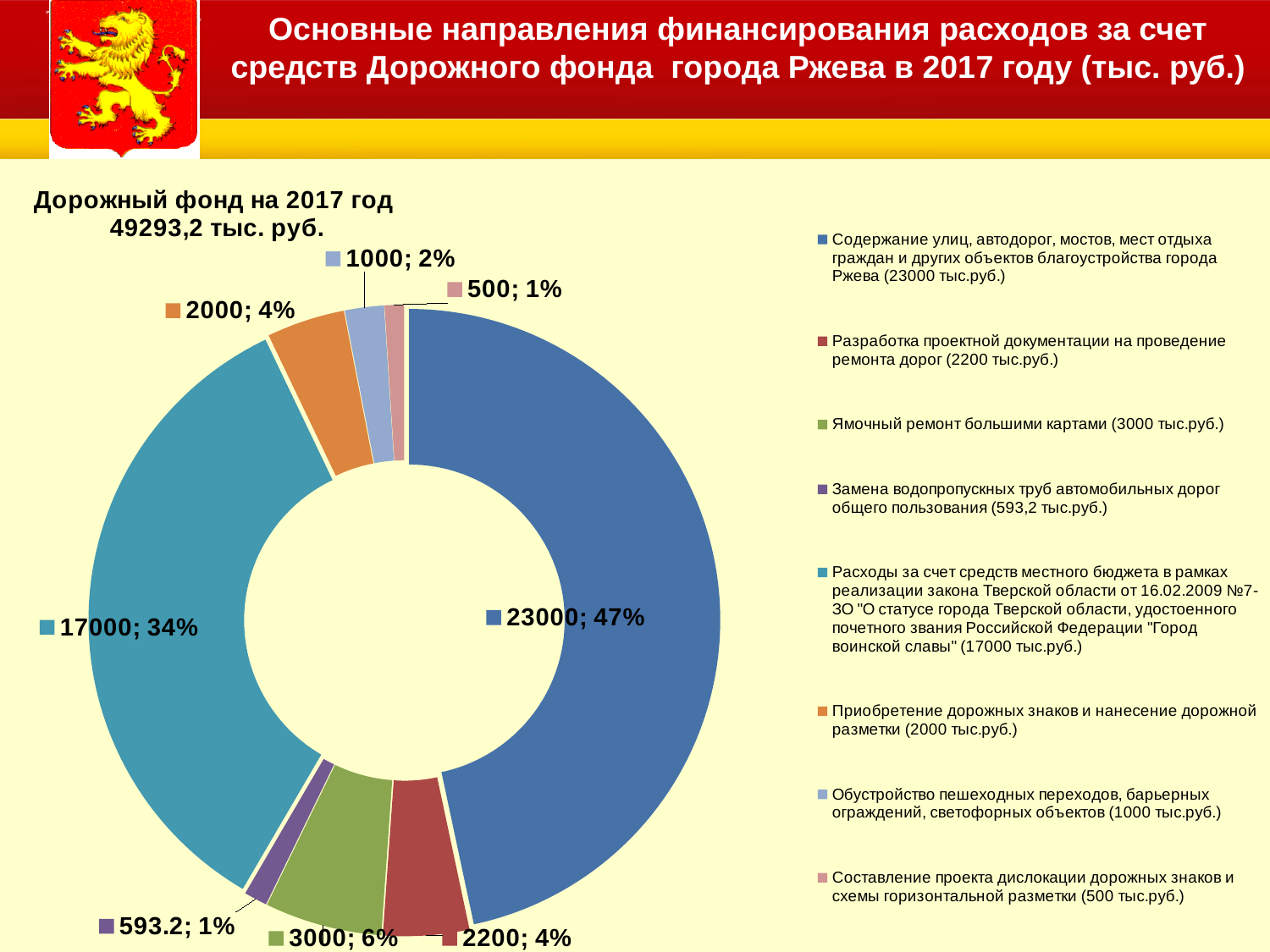
Which is larger: the value for 'Приобретение дорожных знаков и нанесение дорожной разметки' or the value for 'Обустройство пешеходных переходов, барьерных ограждений, светофорных объектов'? Приобретение дорожных знаков и нанесение дорожной разметки Which category has the largest slice? Содержание улиц, автодорог, мостов, мест отдыха граждан и других объектов благоустройства города Ржева How many slices does the pie chart have? 8 Which category has the smallest slice? Составление проекта дислокации дорожных знаков и схемы горизонтальной разметки What share of the pie does the slice for 'Содержание улиц, автодорог, мостов, мест отдыха граждан и других объектов благоустройства города Ржева' represent? 47% What is the difference between the value for 'Содержание улиц...' (23000) and the value for 'Расходы за счет средств местного бюджета...' (17000)? 6000 What total amount of the road fund for 2017 is stated in the chart title? 49293,2 тыс. руб. What is the value for 'Замена водопропускных труб автомобильных дорог общего пользования'? 593.2 What share of the pie does the slice for 'Расходы за счет средств местного бюджета в рамках реализации закона Тверской области...' represent? 34% What is the value for 'Ямочный ремонт большими картами'? 3000 What kind of chart is shown on the slide? pie chart (doughnut) How many entries does the legend list? 8